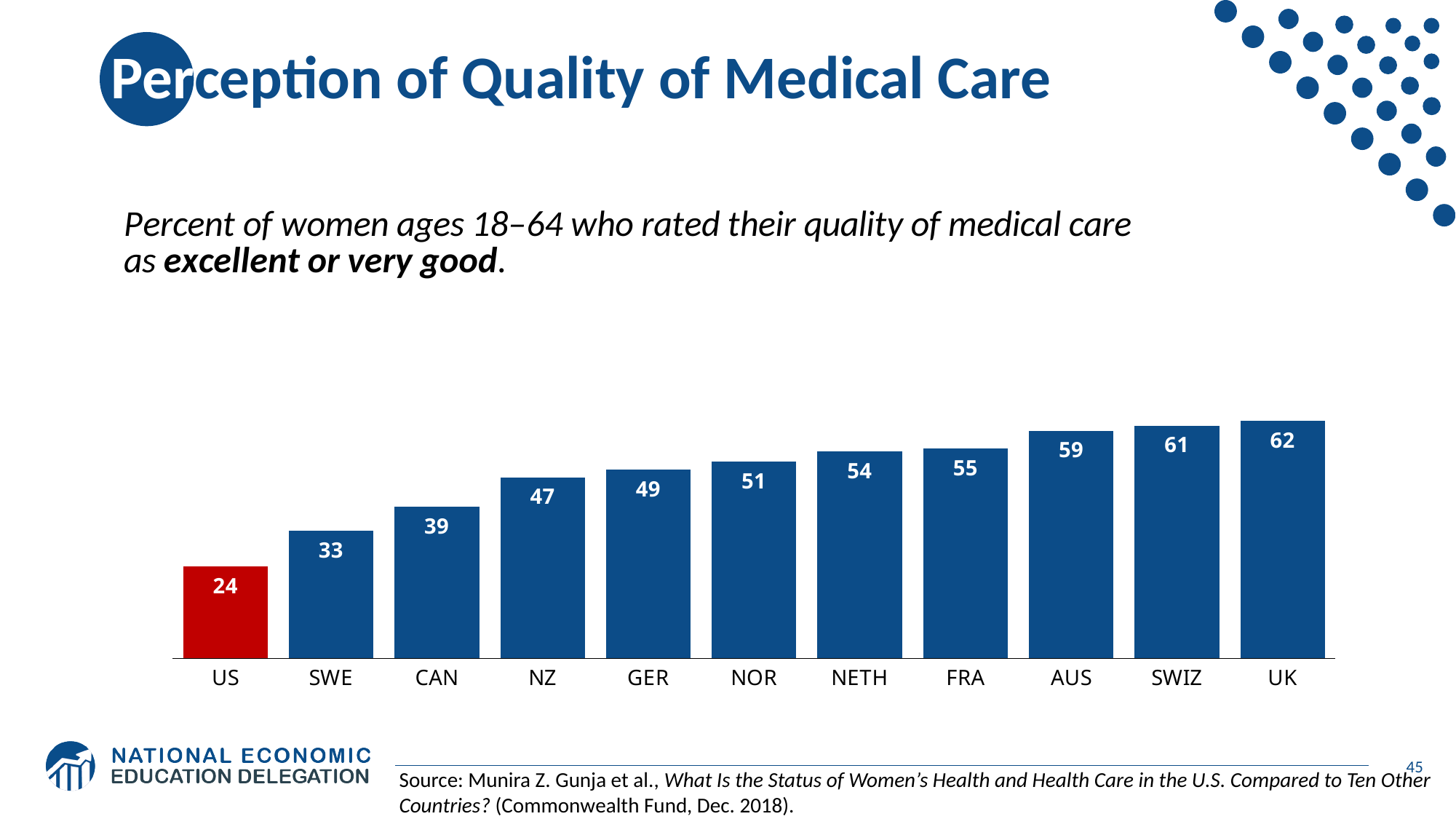
What is the value for AUS? 59 What is the value for the US? 24 Which bar is coloured red rather than blue? US What is the difference between the values for UK and US? 38 What is the value for GER? 49 Which has a larger value, NOR or NZ? NOR How many countries are shown in the chart? 11 Do the values rise or fall from left to right along the x axis? rise Which country has the lowest value? US What kind of chart is shown on the slide? bar chart Which country has the highest value? UK What is the difference between the values for CAN and SWE? 6